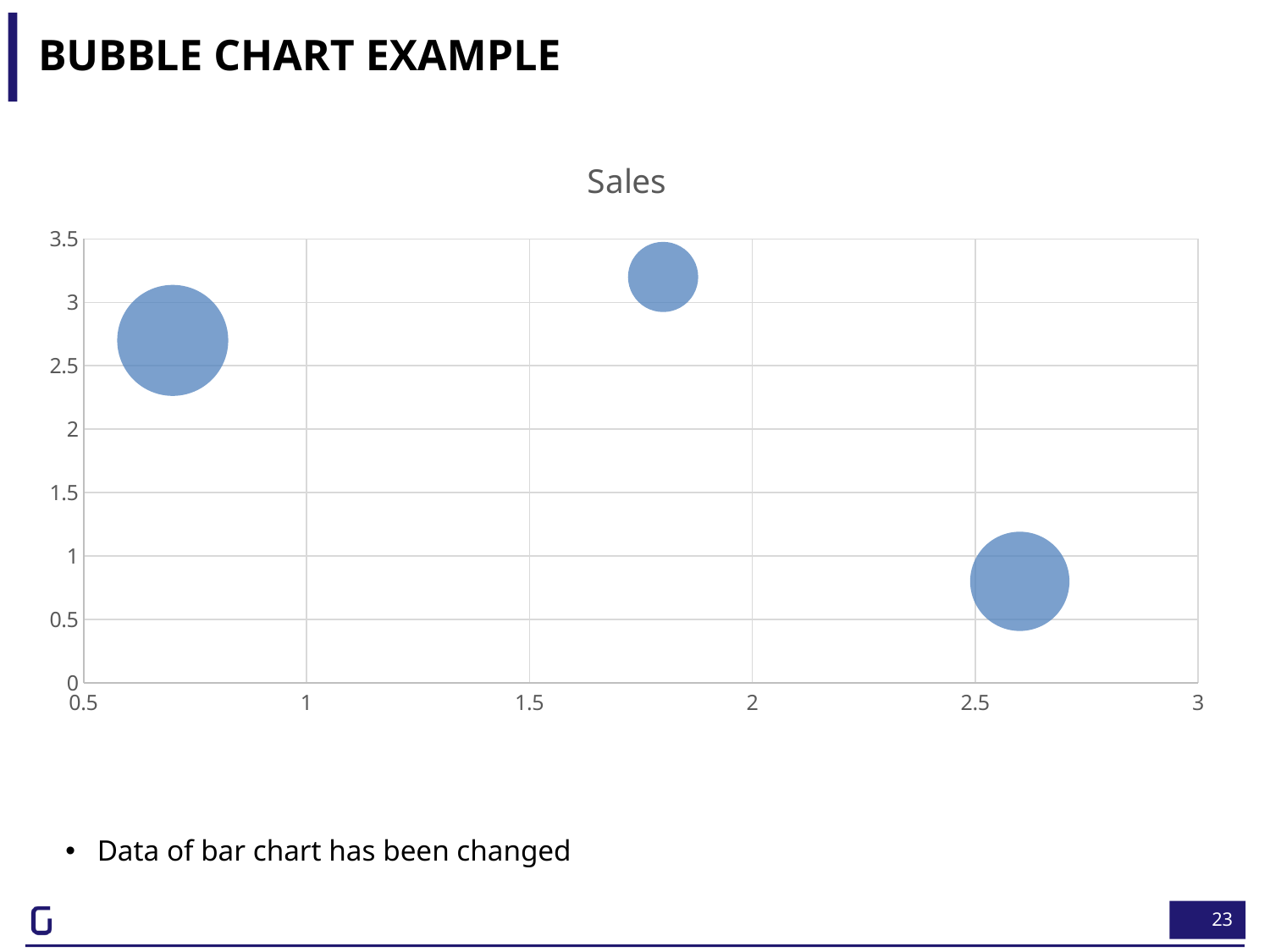
Is the y-axis value of the rightmost bubble (near x = 2.6) greater or less than 1? less What is the title of the chart? Sales Which bubble is larger in size: the leftmost bubble or the bubble near x = 1.8? The leftmost bubble Is the y-axis value of the leftmost bubble (near x = 0.7) greater or less than 2.5? greater Which bubble sits lowest on the y axis: the one near x = 0.7, the one near x = 1.8, or the one near x = 2.6? The one near x = 2.6 How many bubbles are plotted in the chart? 3 What colour are the bubbles in the chart? Blue Is the y-axis value of the bubble near x = 1.8 greater or less than 3? greater What kind of chart is shown on the slide? Bubble chart Which bubble sits highest on the y axis: the one near x = 0.7, the one near x = 1.8, or the one near x = 2.6? The one near x = 1.8